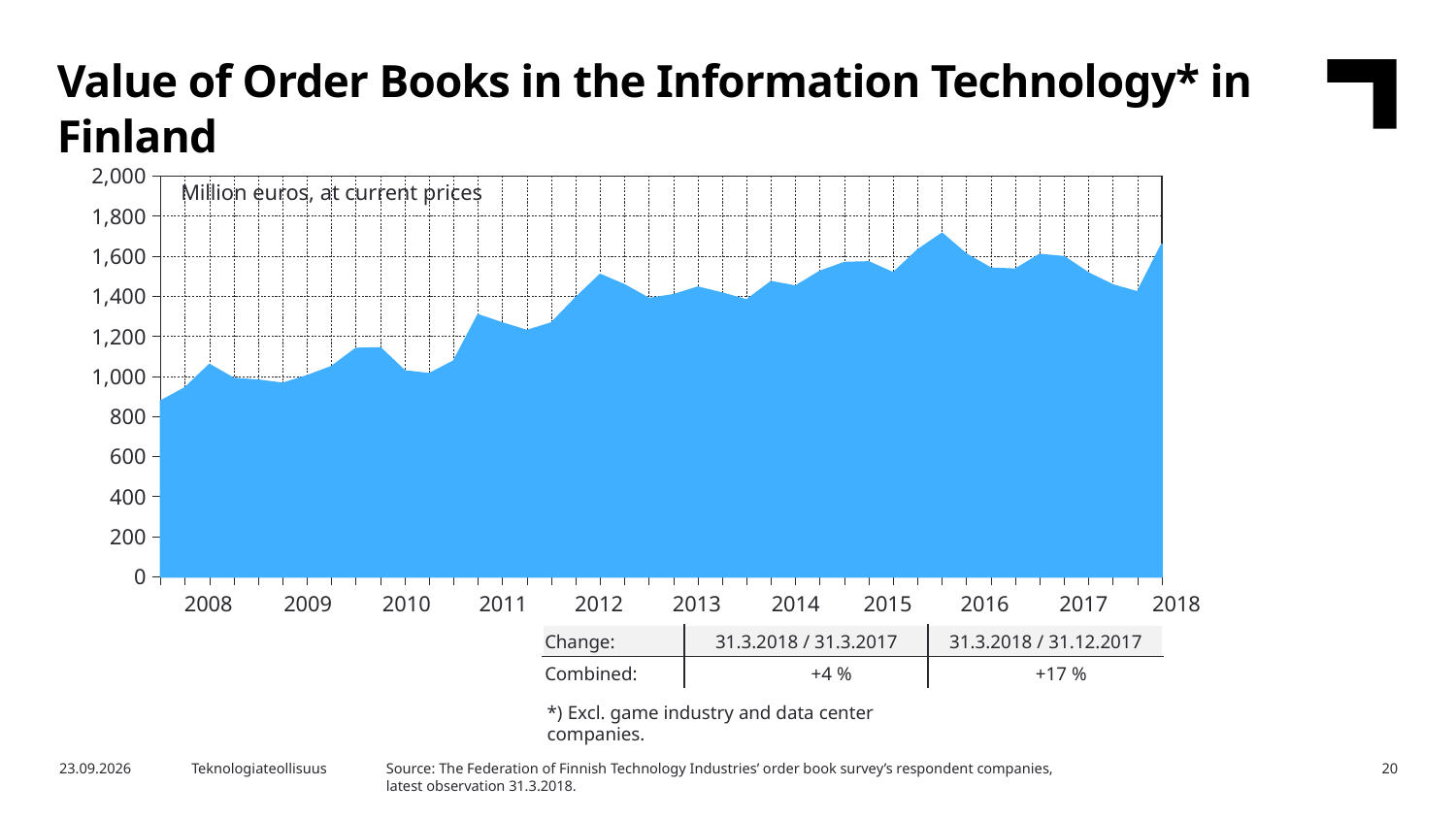
In what unit are the values on the chart expressed, according to the label inside the plot area? Million euros, at current prices What kind of chart is shown on the slide? Area chart What is the combined change in order books for 31.3.2018 compared with 31.12.2017, as shown in the table below the chart? +17 % What is the title of the chart on the slide? Value of Order Books in the Information Technology* in Finland What is the combined change in order books for 31.3.2018 compared with 31.3.2017, as shown in the table below the chart? +4 % Is the value of order books at the start of 2008 greater or less than 1,000? less Overall, do the values of order books rise or fall from 2008 to 2018? rise Is the value of order books at the start of 2011 greater or less than 1,400? less Is the value of order books at the 2018 end of the series greater or less than 1,400? greater How many year labels are shown on the x axis of the chart? 11